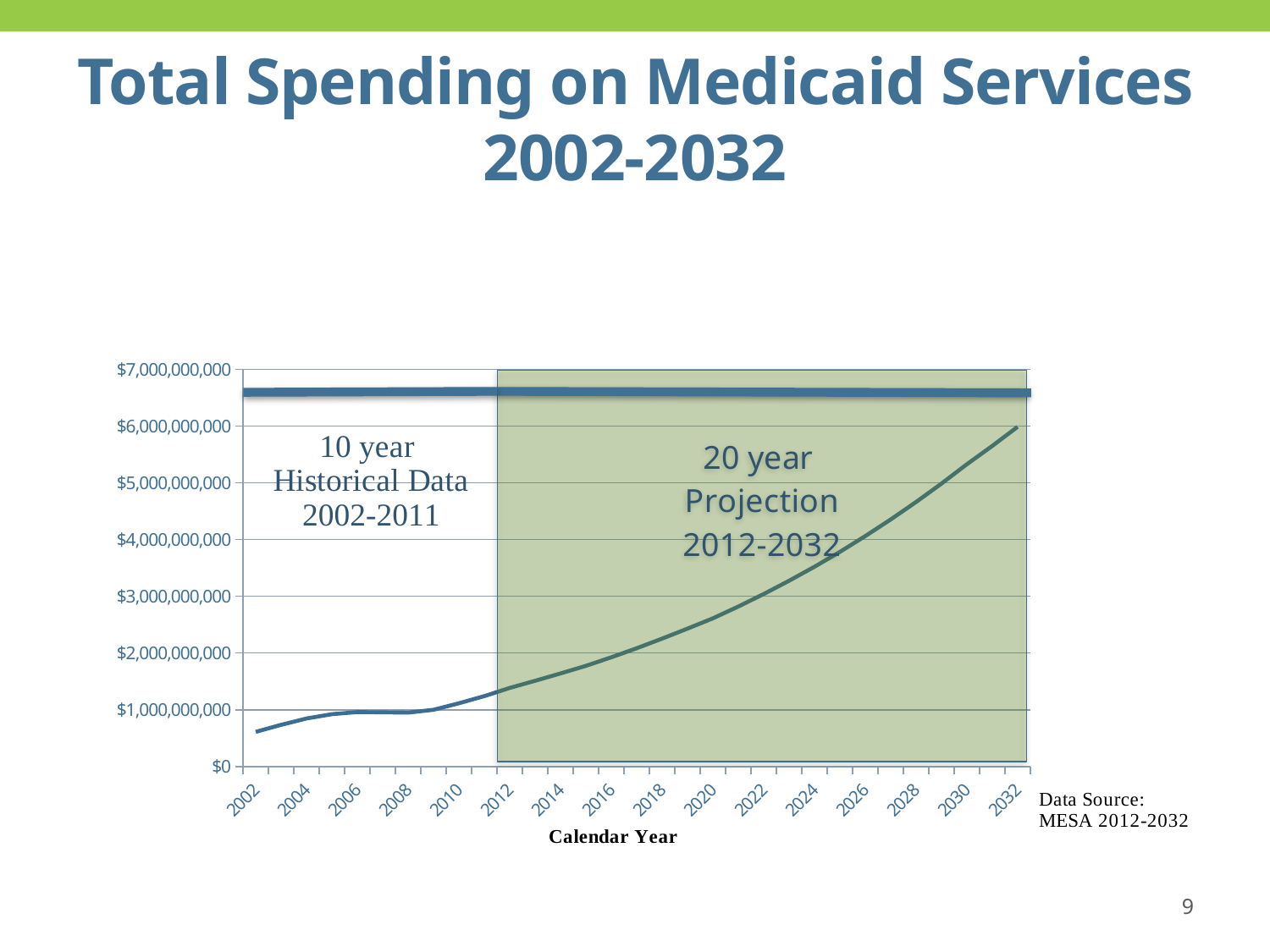
Which year has the highest total spending on the chart? 2032 Is the value for 2002 greater or less than $1,000,000,000? less What is the label of the x axis? Calendar Year Is the value for 2012 greater or less than $1,000,000,000? greater Is the value for 2032 greater or less than $5,000,000,000? greater Which year has the lowest total spending on the chart? 2002 Does total spending rise or fall from 2002 to 2032? rise What kind of chart is shown on the slide? line chart What is the title of the chart on the slide? Total Spending on Medicaid Services 2002-2032 How many year labels are shown on the x axis? 16